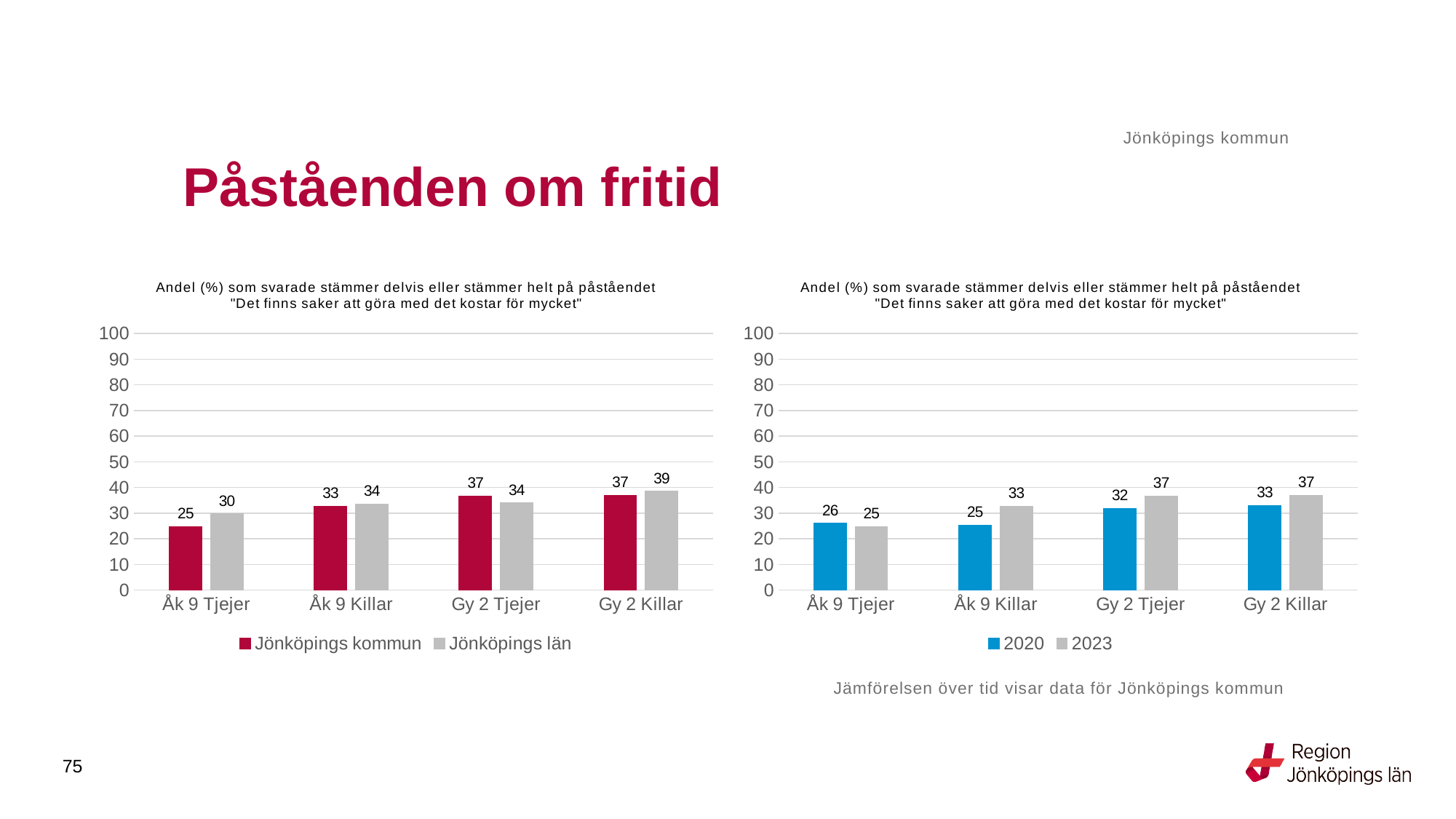
How many categories are shown on the x axis of the left chart? 4 In the left chart, what is the value for Jönköpings län for Gy 2 Killar? 39 What type of chart is the right chart? Bar chart In the right chart, what is the value for 2023 for Åk 9 Killar? 33 In the left chart, what is the value for Jönköpings kommun for Åk 9 Tjejer? 25 In the left chart, which is larger for Gy 2 Tjejer: Jönköpings kommun or Jönköpings län? Jönköpings kommun In the right chart, what is the difference between 2023 and 2020 for Åk 9 Killar? 8 In the right chart, which category has the highest value for 2023? Gy 2 Tjejer and Gy 2 Killar (both 37) In the right chart, what is the value for 2020 for Gy 2 Tjejer? 32 In the left chart, what is the difference between Jönköpings län and Jönköpings kommun for Åk 9 Tjejer? 5 In the left chart, which category has the lowest value for Jönköpings kommun? Åk 9 Tjejer In the right chart, how many series does the legend list? 2